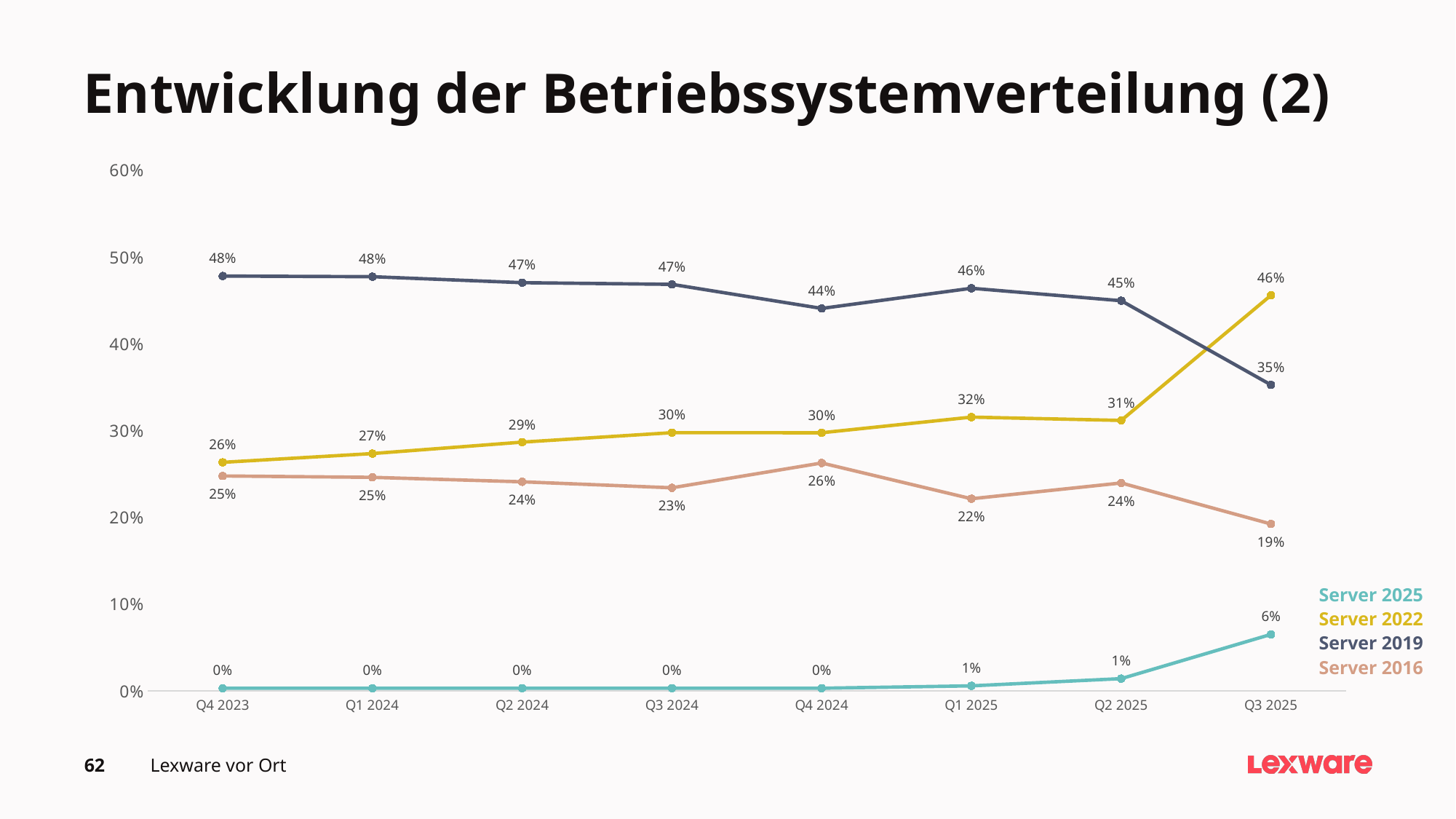
What kind of chart is shown on the slide? Line chart Which series has the highest value in Q3 2025? Server 2022 How many quarters are shown on the x axis? 8 What is the difference between Server 2019 and Server 2022 in Q2 2025? 14% How many series does the legend list? 4 What is the value for Server 2025 in Q3 2025? 6% Which series has the lowest value in Q1 2025? Server 2025 Which is larger in Q3 2025: Server 2019 or Server 2016? Server 2019 Does the Server 2016 line rise or fall from Q2 2025 to Q3 2025? Fall What is the value for Server 2022 in Q3 2025? 46% What is the value for Server 2016 in Q4 2024? 26% What is the value for Server 2019 in Q4 2023? 48%